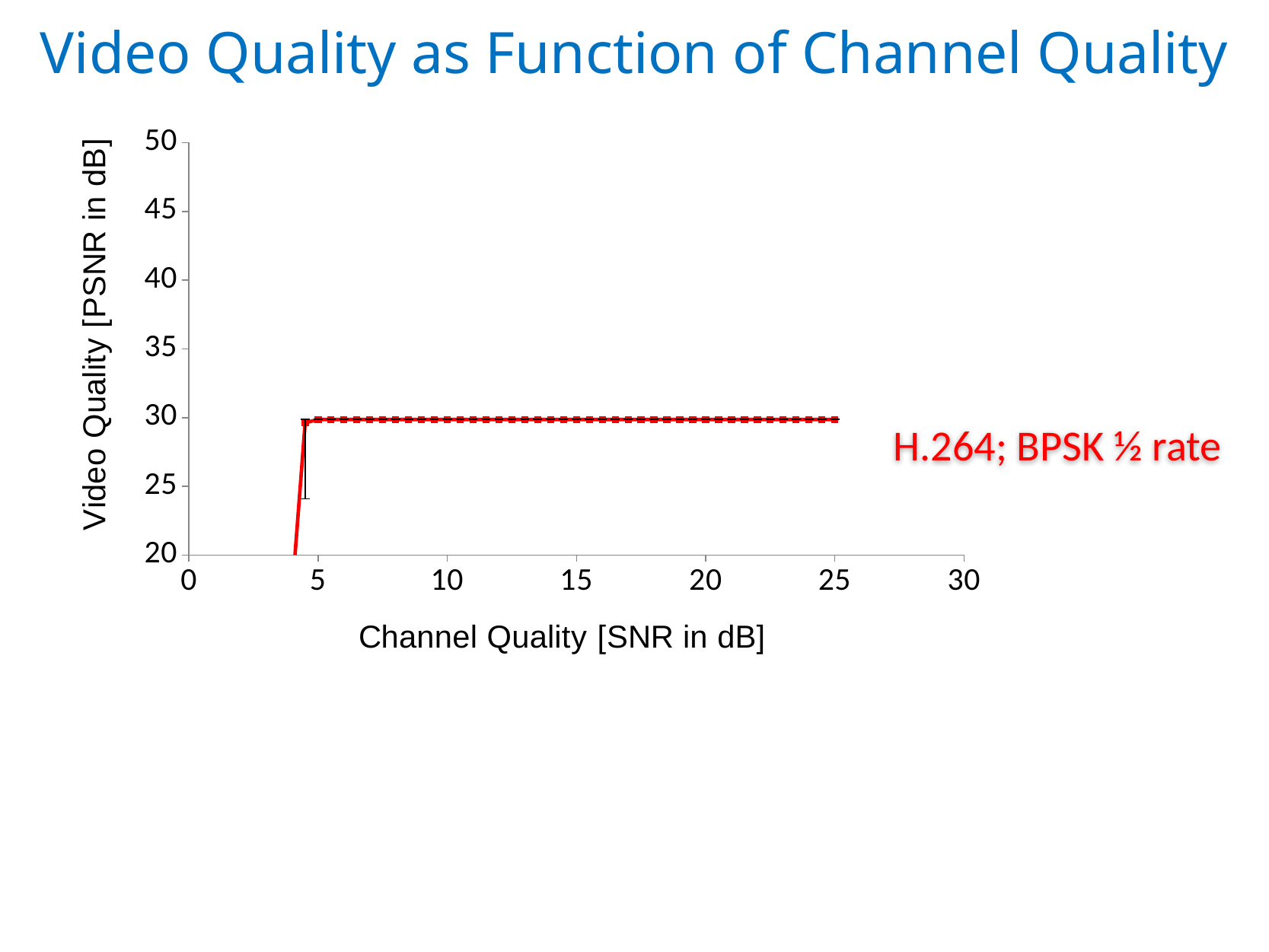
Is the video quality at a channel quality of 10 dB greater or less than 40? less What is the title of the slide's chart? Video Quality as Function of Channel Quality What kind of chart is shown on the slide? line chart Between a channel quality of 5 dB and 25 dB, does the video quality rise, fall, or stay roughly flat? stay roughly flat What is the label of the x axis? Channel Quality [SNR in dB] Is the video quality at a channel quality of 20 dB greater or less than 25? greater What is the highest value shown on the x axis? 30 Is the video quality at a channel quality of 25 dB greater or less than 45? less Between a channel quality of 4 dB and 5 dB, does the video quality rise or fall? rise